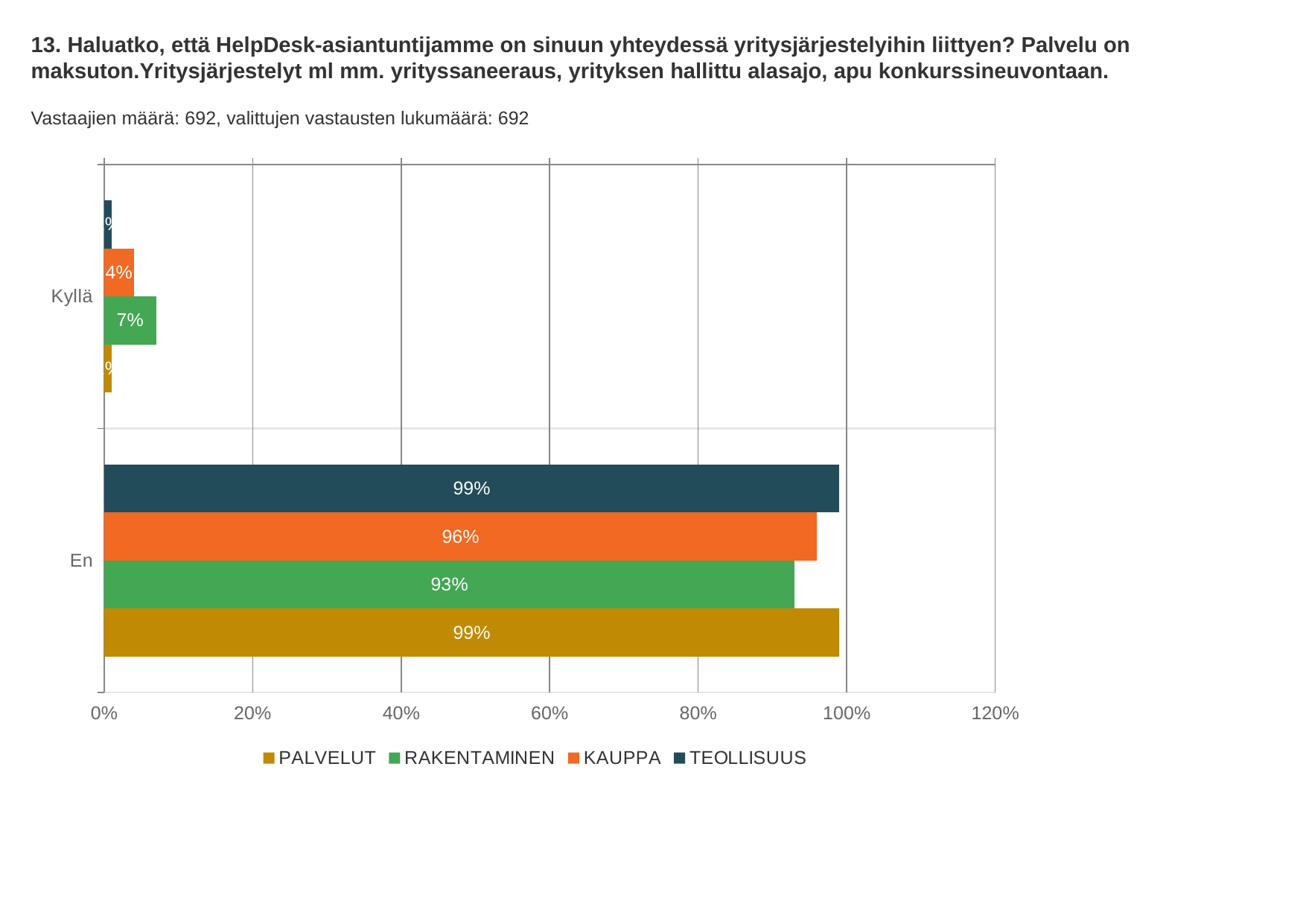
Which series has the lowest value in the En category? RAKENTAMINEN What is the value for KAUPPA in the En category? 96% How many series does the legend list? 4 What is the value for TEOLLISUUS in the En category? 99% What is the difference between the KAUPPA and RAKENTAMINEN values in the En category? 3% What is the value for KAUPPA in the Kyllä category? 4% What is the value for RAKENTAMINEN in the En category? 93% Which series has the highest value in the Kyllä category? RAKENTAMINEN What kind of chart is shown on the slide? bar chart How many categories are shown on the vertical axis? 2 Is the value for PALVELUT in the Kyllä category greater or less than 20%? less What is the value for RAKENTAMINEN in the Kyllä category? 7%